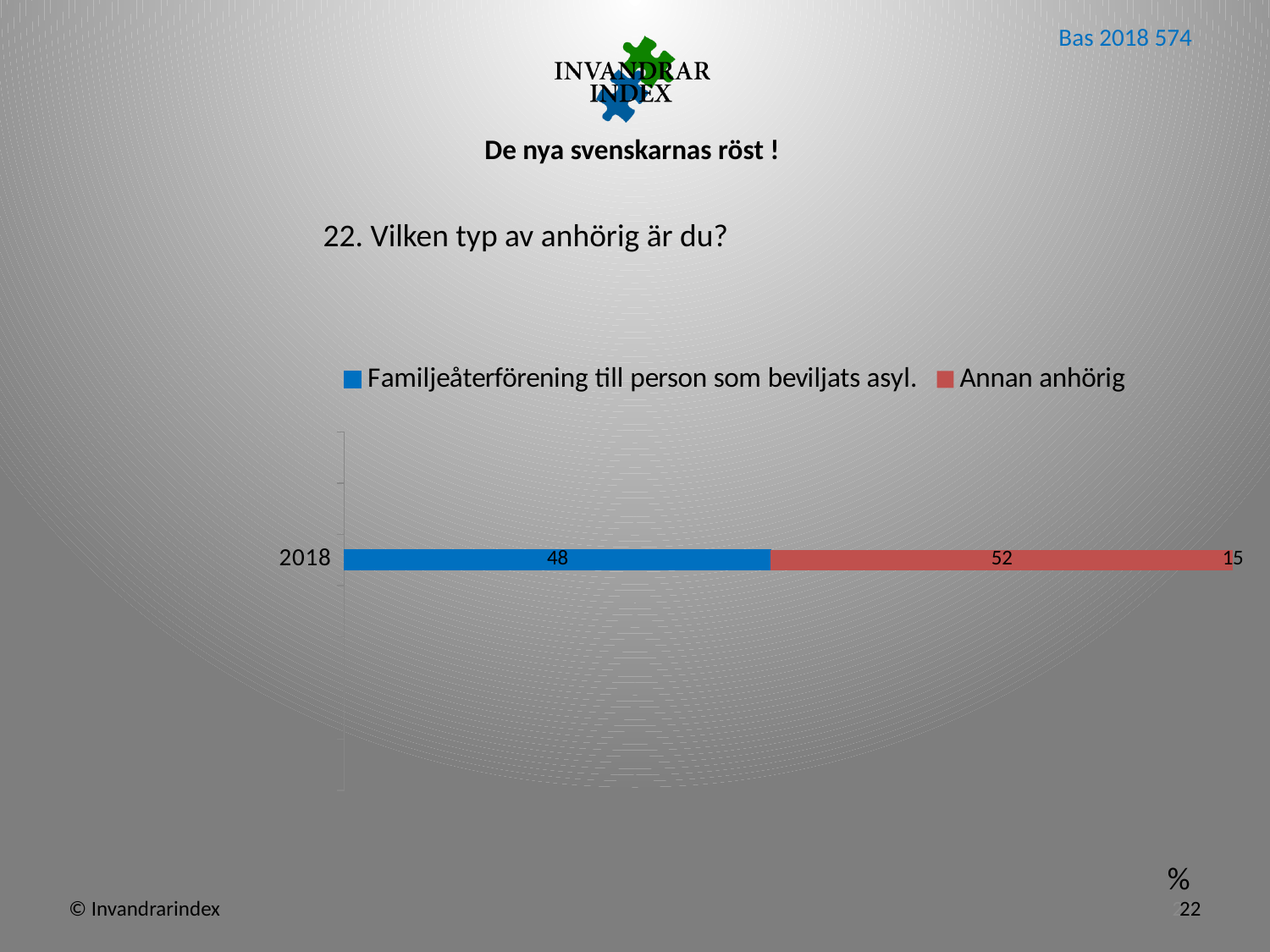
How many series does the chart legend list? 2 How many categories are shown on the chart's category axis? 1 What value is shown for "Familjeåterförening till person som beviljats asyl." in 2018? 48 What is the difference between the values for "Annan anhörig" and "Familjeåterförening till person som beviljats asyl." in 2018? 4 Which series has the larger value in 2018, "Familjeåterförening till person som beviljats asyl." or "Annan anhörig"? Annan anhörig What kind of chart is shown on the slide? Stacked bar chart What value is shown for "Annan anhörig" in 2018? 52 Which year is shown as the category on the chart? 2018 What colour represents "Annan anhörig" in the chart? Red